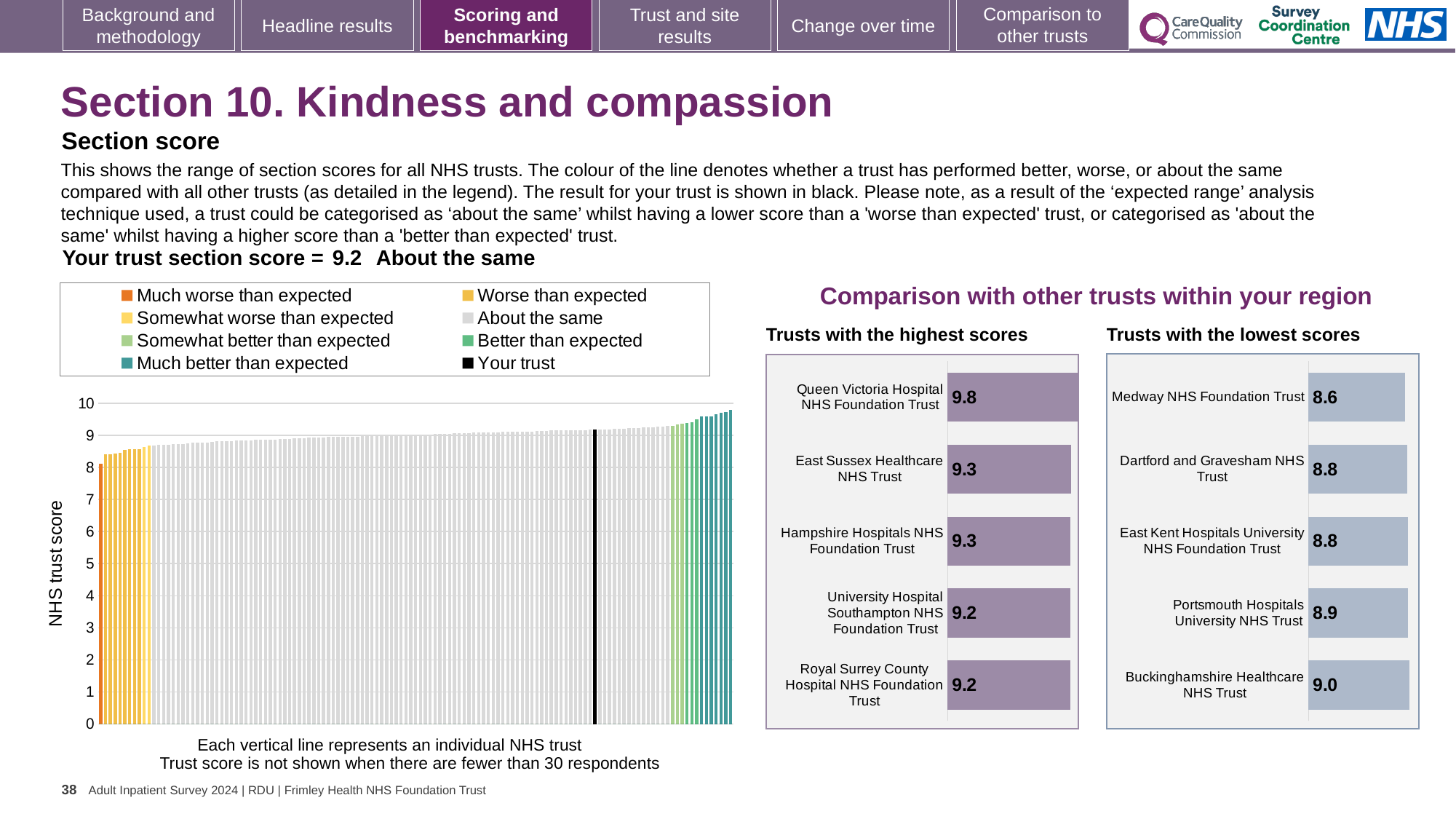
In the 'Trusts with the highest scores' chart, what is the score for Queen Victoria Hospital NHS Foundation Trust? 9.8 What kind of chart is the left-hand chart showing the range of section scores for all NHS trusts? Bar chart In the 'Trusts with the lowest scores' chart, which has the larger score: Portsmouth Hospitals University NHS Trust or Medway NHS Foundation Trust? Portsmouth Hospitals University NHS Trust In the 'Trusts with the lowest scores' chart, what is the score for Buckinghamshire Healthcare NHS Trust? 9.0 How many entries does the legend of the left-hand chart of all NHS trusts list? 8 How many trusts are listed in the 'Trusts with the highest scores' chart? 5 In the left-hand chart of all NHS trusts, do the scores rise or fall from left to right? Rise What is the difference between the score for Queen Victoria Hospital NHS Foundation Trust in the highest scores chart and the score for Medway NHS Foundation Trust in the lowest scores chart? 1.2 In the 'Trusts with the highest scores' chart, which trust has the highest score? Queen Victoria Hospital NHS Foundation Trust In the 'Trusts with the lowest scores' chart, which trust has the lowest score? Medway NHS Foundation Trust In the 'Trusts with the lowest scores' chart, what is the score for Medway NHS Foundation Trust? 8.6 In the 'Trusts with the highest scores' chart, what is the difference between the scores of Queen Victoria Hospital NHS Foundation Trust and East Sussex Healthcare NHS Trust? 0.5